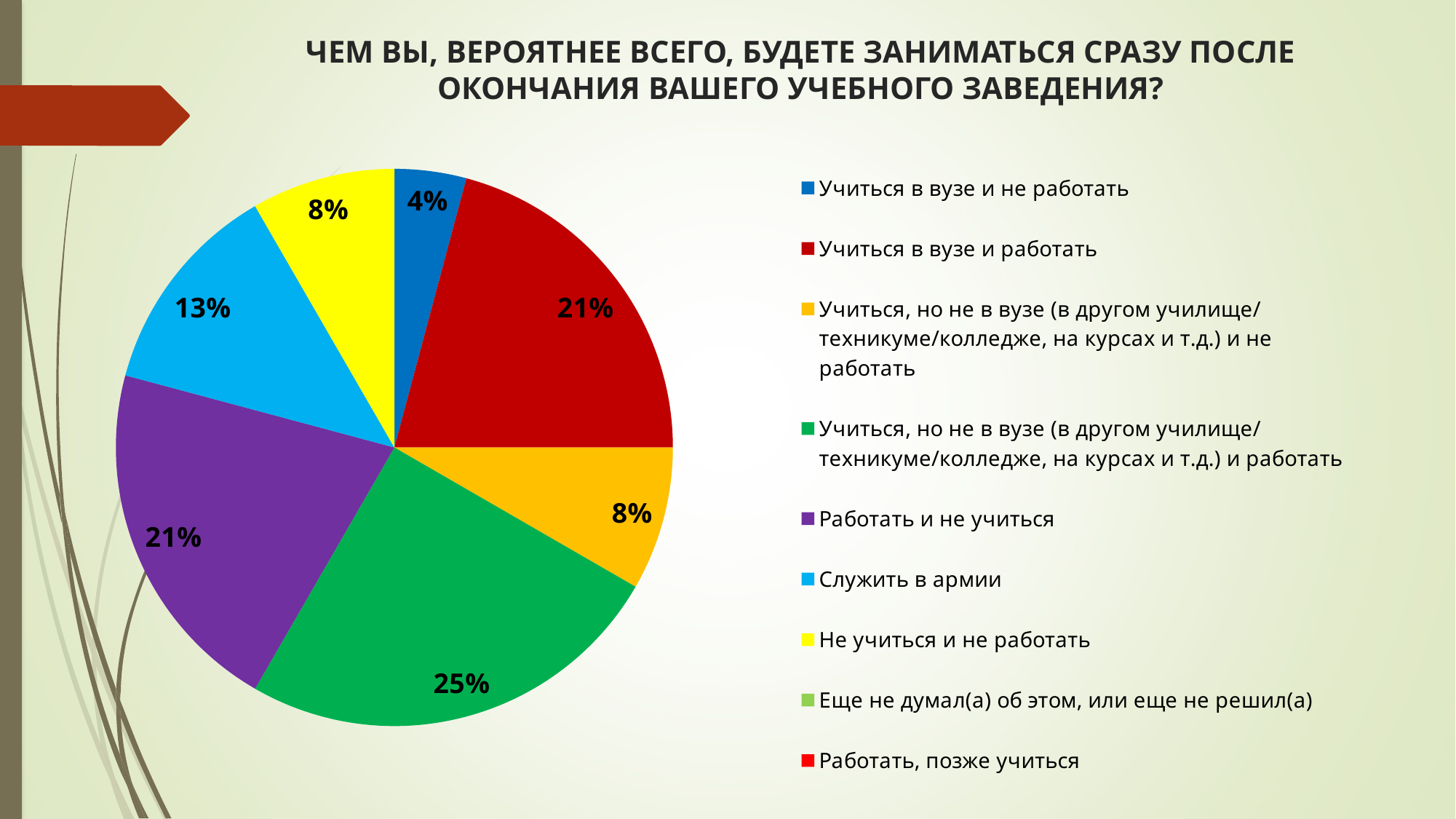
Which category has the smallest visible slice of the pie? Учиться в вузе и не работать What percentage is shown for "Работать и не учиться"? 21% What percentage is shown for "Не учиться и не работать"? 8% What kind of chart is shown on the slide? pie chart What is the title of the chart? ЧЕМ ВЫ, ВЕРОЯТНЕЕ ВСЕГО, БУДЕТЕ ЗАНИМАТЬСЯ СРАЗУ ПОСЛЕ ОКОНЧАНИЯ ВАШЕГО УЧЕБНОГО ЗАВЕДЕНИЯ? Which is larger: the slice for "Учиться в вузе и работать" or the slice for "Служить в армии"? Учиться в вузе и работать What share of the pie is labelled for "Учиться в вузе и не работать"? 4% What percentage is shown for "Служить в армии"? 13% Which category has the largest slice of the pie? Учиться, но не в вузе (в другом училище/техникуме/колледже, на курсах и т.д.) и работать What is the difference in percentage points between the largest slice (25%) and the slice for "Служить в армии"? 12 How many entries does the legend list? 9 What colour is the slice for "Служить в армии"? light blue